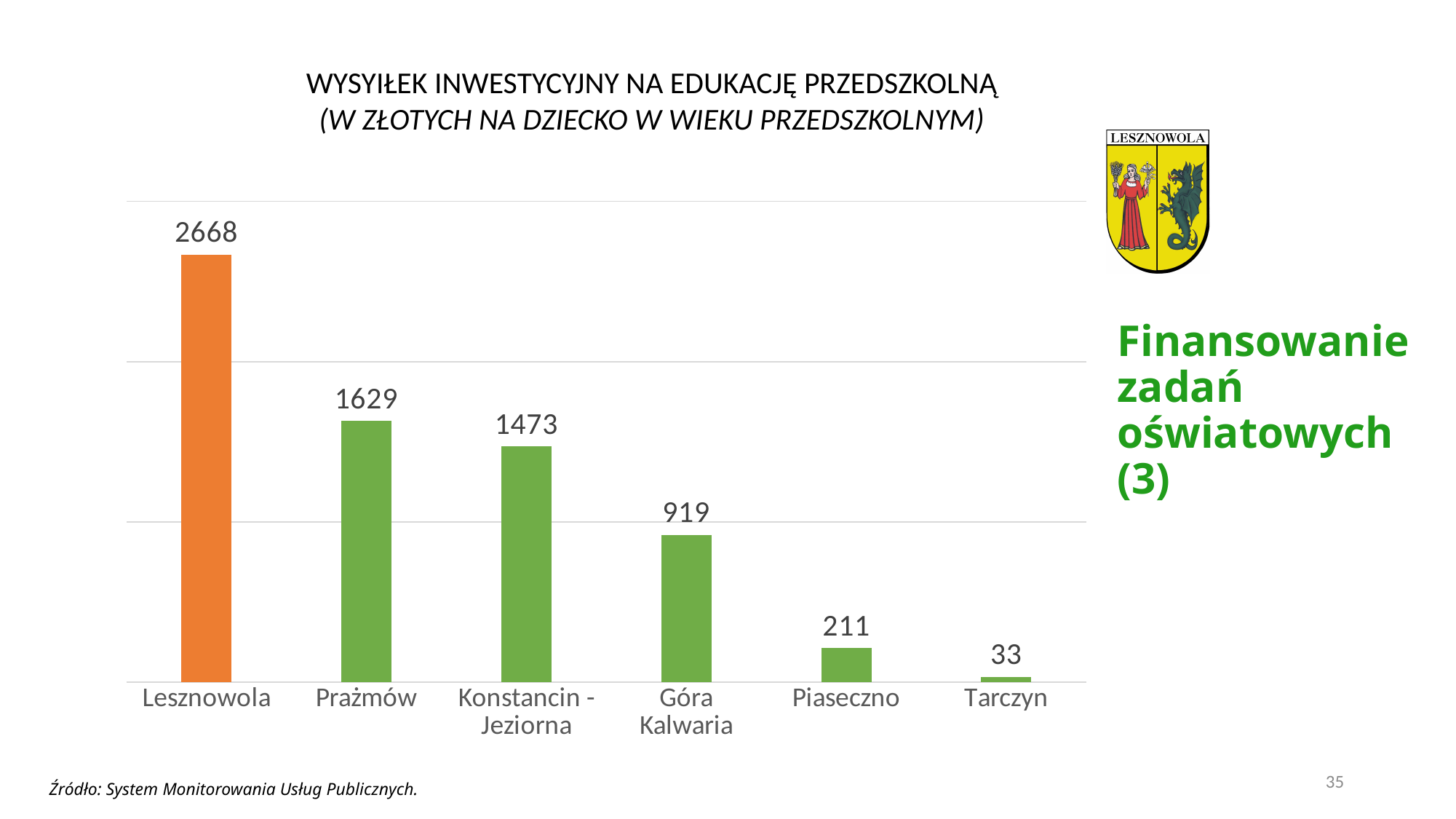
What is the difference between the values for Lesznowola and Prażmów? 1039 Which category has the highest value? Lesznowola Which bar is coloured orange rather than green? Lesznowola Do the values rise or fall from left to right along the x axis? Fall What is the value for Piaseczno? 211 What is the value for Lesznowola? 2668 How many categories are shown in the chart? 6 Which category has the lowest value? Tarczyn What is the value for Konstancin - Jeziorna? 1473 What is the difference between the values for Góra Kalwaria and Piaseczno? 708 What kind of chart is shown on the slide? Bar chart Which is larger, the value for Prażmów or the value for Konstancin - Jeziorna? Prażmów